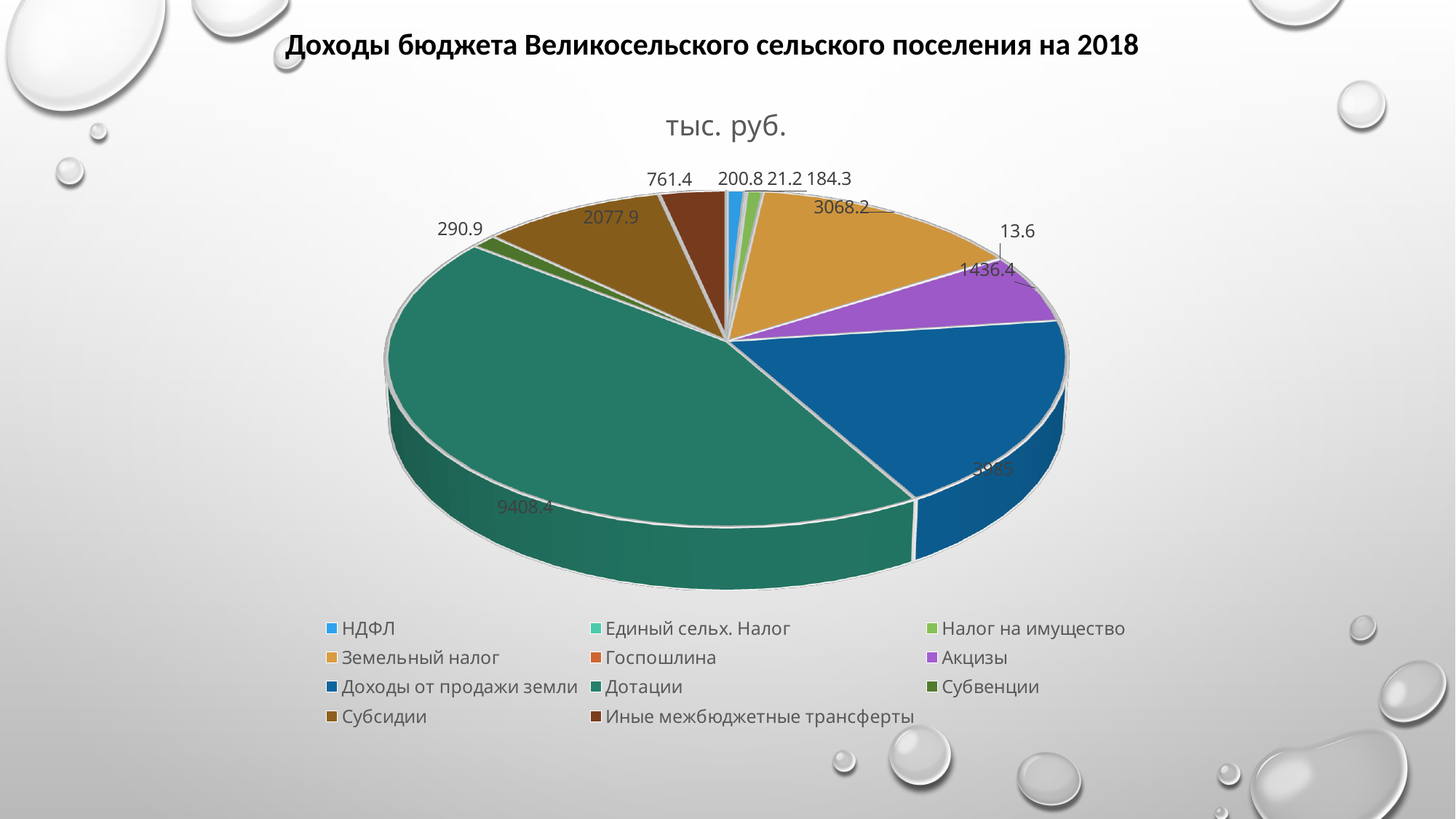
Which category has the largest slice? Дотации How many categories does the pie chart have? 11 What is the value for Акцизы? 1436.4 What is the value for Дотации? 9408.4 What is the value for Земельный налог? 3068.2 What is the value for Госпошлина? 13.6 Which is larger, Земельный налог or Субсидии? Земельный налог What is the difference between Дотации and Доходы от продажи земли? 5423.4 What kind of chart is shown on the slide? pie chart What is the value for Субсидии? 2077.9 What is the chart's title shown above the pie? тыс. руб. Which category has the smallest value? Госпошлина